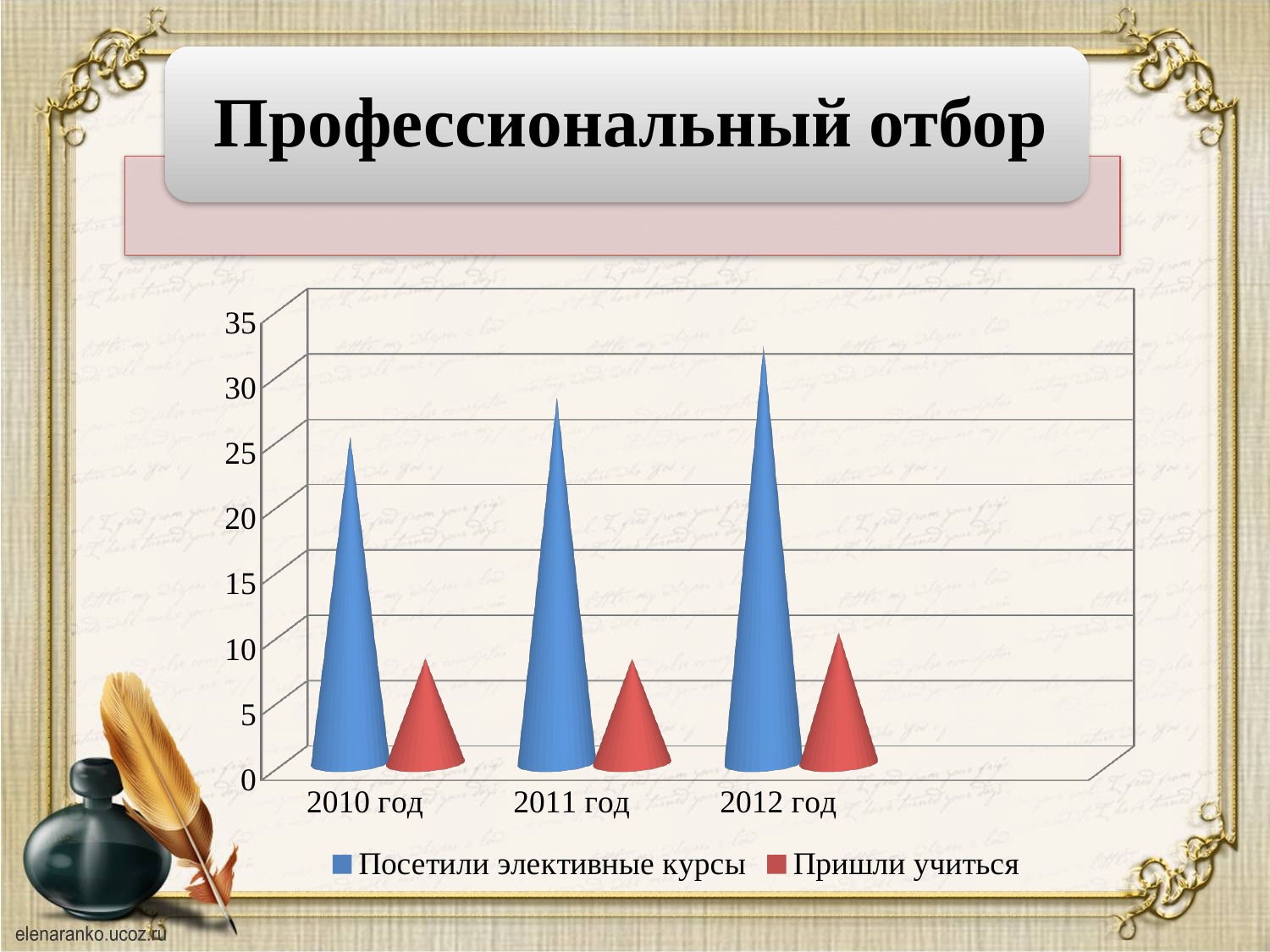
In which year is the value for "Пришли учиться" the highest? 2012 год Is the value for "Посетили элективные курсы" in 2010 год greater or less than 20? greater How many series does the chart legend list? 2 Do the values for "Посетили элективные курсы" rise or fall from 2010 год to 2012 год? rise What kind of chart is shown on the slide? bar chart Is the value for "Посетили элективные курсы" in 2012 год greater or less than 30? greater In 2011 год, which series has the larger value: "Посетили элективные курсы" or "Пришли учиться"? Посетили элективные курсы Is the value for "Пришли учиться" in 2012 год greater or less than 15? less How many categories (years) are shown on the x axis of the chart? 3 In which year is the value for "Посетили элективные курсы" the highest? 2012 год In which year is the value for "Посетили элективные курсы" the lowest? 2010 год Which colour represents the series "Пришли учиться" in the chart? red